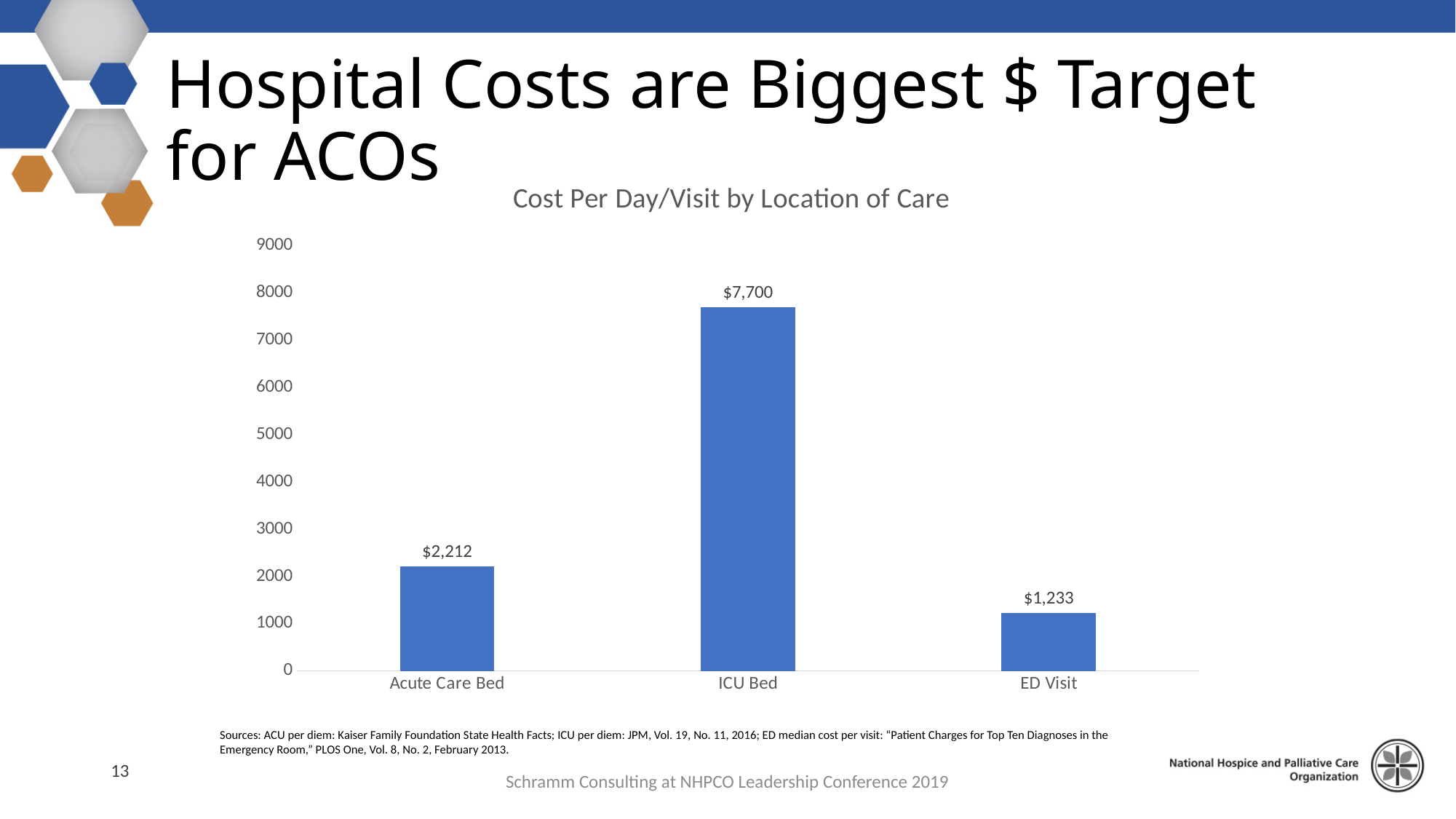
What is the title of the chart? Cost Per Day/Visit by Location of Care Which location of care has the highest cost per day/visit? ICU Bed Which location of care has the lowest cost per day/visit? ED Visit What is the cost per day for an ICU Bed? $7,700 What is the cost per day for an Acute Care Bed? $2,212 What type of chart is used to show cost per day/visit by location of care? Bar chart Which costs more, an Acute Care Bed or an ED Visit? Acute Care Bed How many locations of care are shown in the chart? 3 Is the value for ICU Bed greater or less than 7000? greater What is the cost per visit for an ED Visit? $1,233 What is the difference in cost between an Acute Care Bed and an ED Visit? $979 How much more does an ICU Bed cost per day than an Acute Care Bed? $5,488